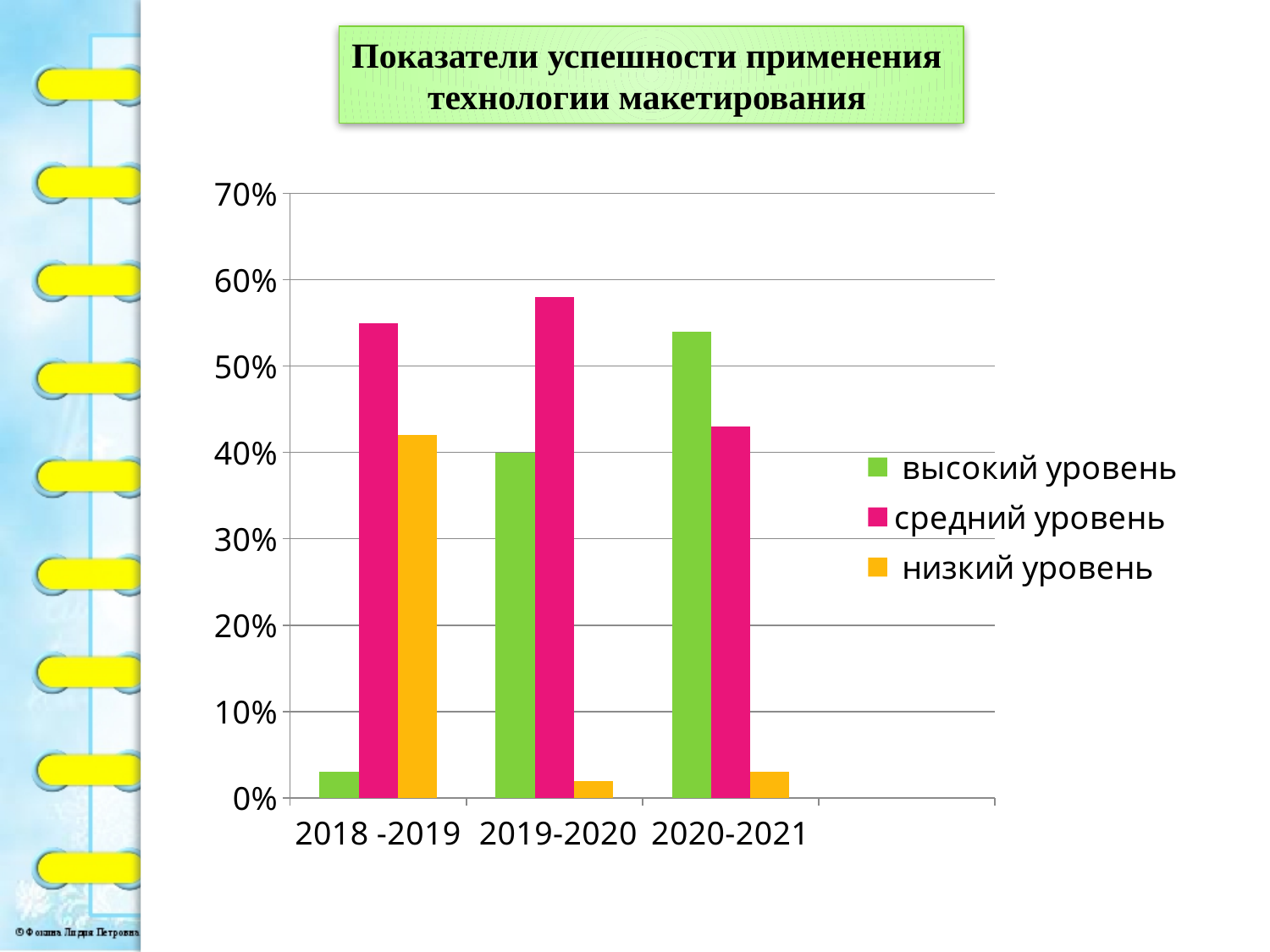
Is the value for 'низкий уровень' in 2018 -2019 greater or less than 40%? greater Is the value for 'высокий уровень' in 2020-2021 greater or less than 50%? greater Is the value for 'средний уровень' in 2019-2020 greater or less than 50%? greater What kind of chart is shown on the slide? bar chart In 2020-2021, which is larger: 'высокий уровень' or 'средний уровень'? высокий уровень Which year has the highest value for 'высокий уровень'? 2020-2021 Which year has the lowest value for 'низкий уровень'? 2019-2020 What is the title of the chart? Показатели успешности применения технологии макетирования How many series does the legend list? 3 How many academic-year categories are shown on the x axis? 3 Which colour represents the series 'низкий уровень' in the legend? orange